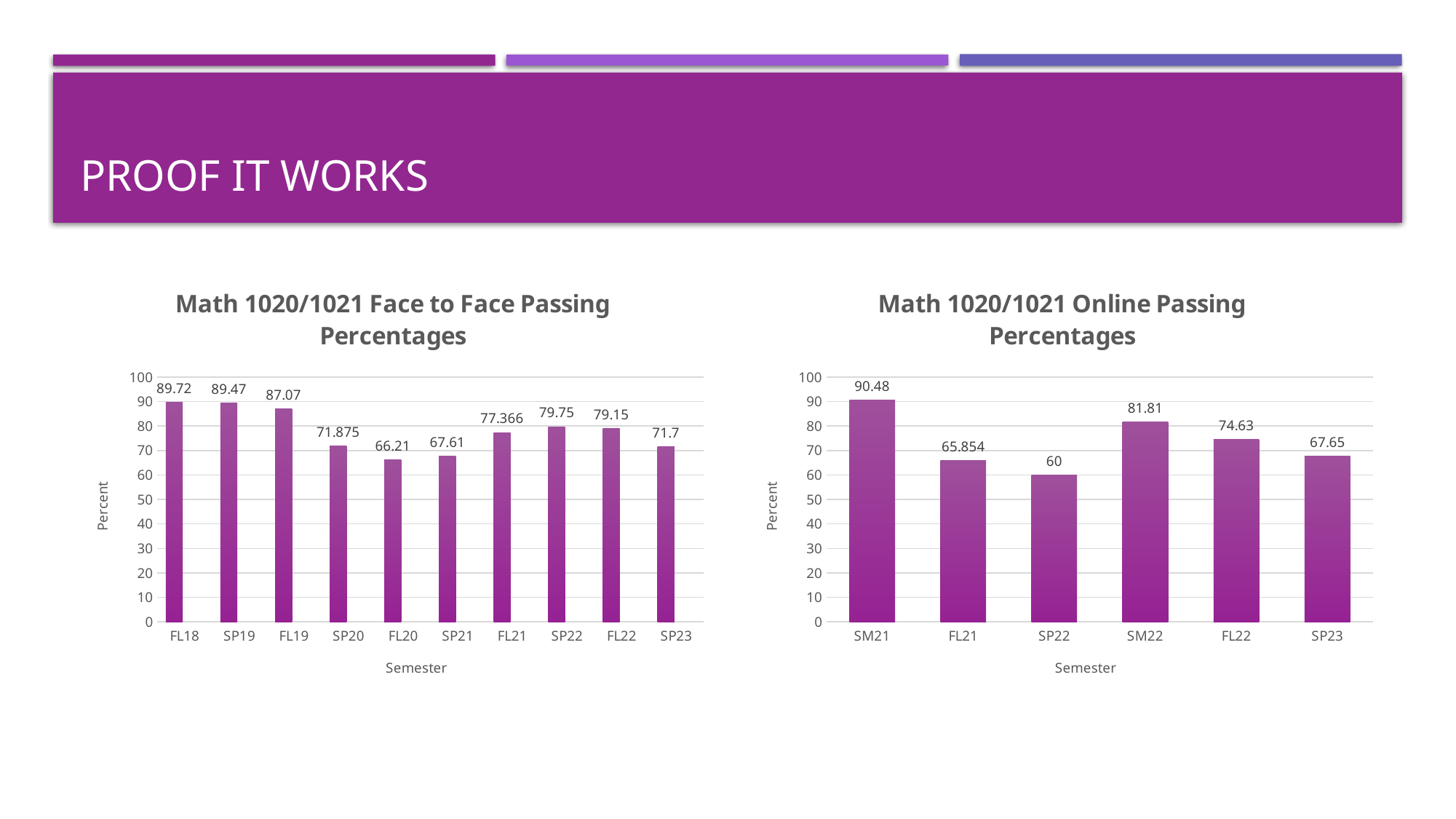
In the Math 1020/1021 Online Passing Percentages chart, which semester has the lowest passing percentage? SP22 What is the label on the vertical axis of the Math 1020/1021 Face to Face Passing Percentages chart? Percent What type of chart is the Math 1020/1021 Online Passing Percentages chart? Bar chart How many semesters are shown in the Math 1020/1021 Face to Face Passing Percentages chart? 10 In the Math 1020/1021 Online Passing Percentages chart, what is the difference between the SM22 and FL22 values? 7.18 In the Math 1020/1021 Face to Face Passing Percentages chart, what is the value for SP20? 71.875 In the Math 1020/1021 Face to Face Passing Percentages chart, what is the difference between the FL18 and FL20 values? 23.51 In the Math 1020/1021 Online Passing Percentages chart, what is the value for FL21? 65.854 In the Math 1020/1021 Online Passing Percentages chart, which semester has the highest passing percentage? SM21 How many semesters are shown in the Math 1020/1021 Online Passing Percentages chart? 6 In the Math 1020/1021 Face to Face Passing Percentages chart, which is larger, the value for SP22 or the value for SP23? SP22 In the Math 1020/1021 Face to Face Passing Percentages chart, which semester has the lowest passing percentage? FL20